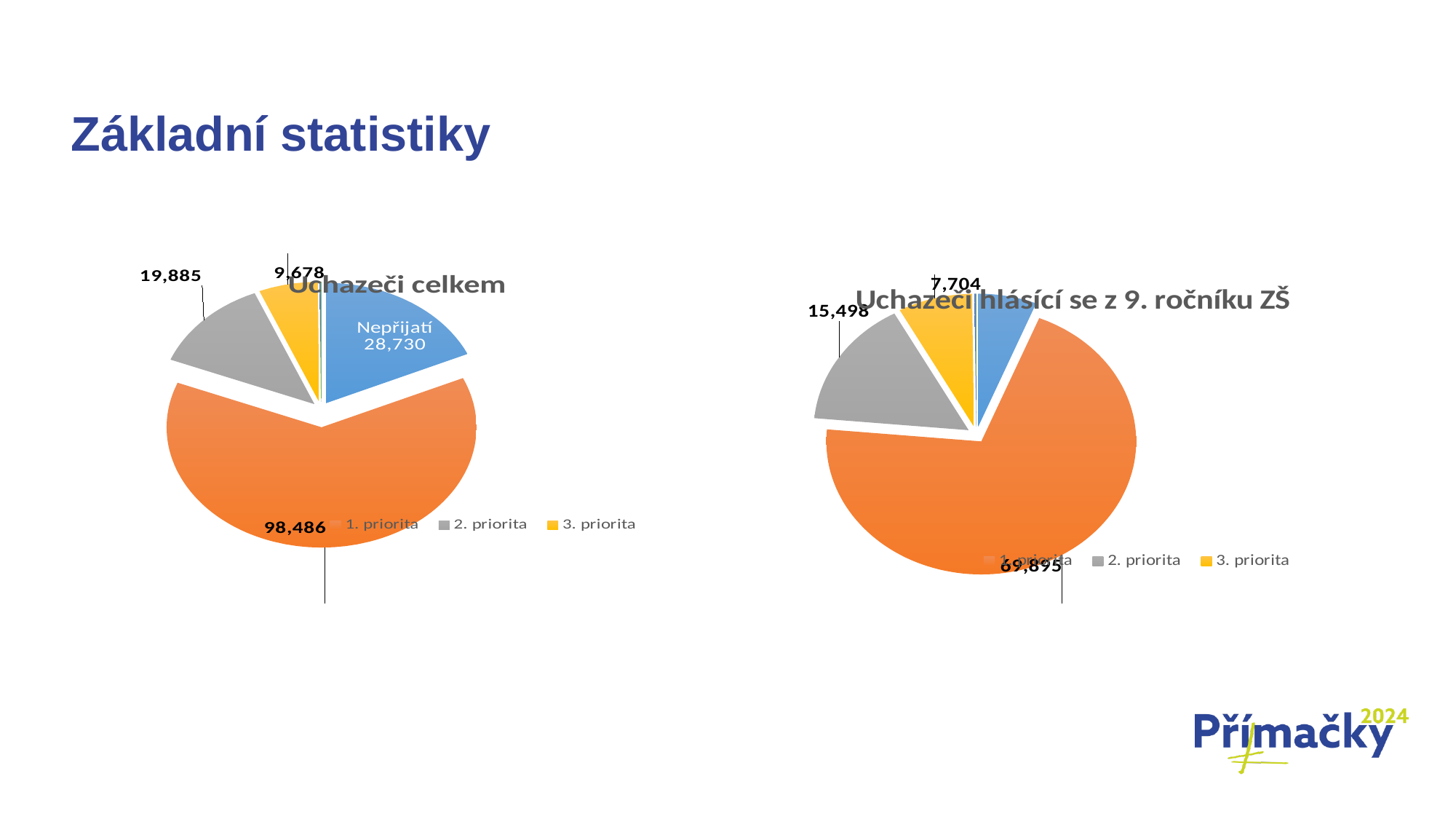
In the 'Uchazeči celkem' chart, which category has the largest slice? 1. priorita In the 'Uchazeči hlásící se z 9. ročníku ZŠ' chart, what is the value of the 2. priorita slice? 15,498 In the 'Uchazeči hlásící se z 9. ročníku ZŠ' chart, what is the difference between the 1. priorita and 2. priorita values? 54,397 In the 'Uchazeči hlásící se z 9. ročníku ZŠ' chart, what is the value of the 1. priorita slice? 69,895 In the 'Uchazeči celkem' chart, what is the difference between the 2. priorita and 3. priorita values? 10,207 In the 'Uchazeči celkem' chart, what is the value of the 1. priorita slice? 98,486 What type of chart is used for 'Uchazeči celkem'? Pie chart In the 'Uchazeči celkem' chart, what is the value of the 2. priorita slice? 19,885 In the 'Uchazeči hlásící se z 9. ročníku ZŠ' chart, which of the labelled categories has the smallest value? 3. priorita In the 'Uchazeči celkem' chart, what value is shown for Nepřijatí? 28,730 In the 'Uchazeči hlásící se z 9. ročníku ZŠ' chart, what is the value of the 3. priorita slice? 7,704 In the 'Uchazeči celkem' chart, what is the value of the 3. priorita slice? 9,678